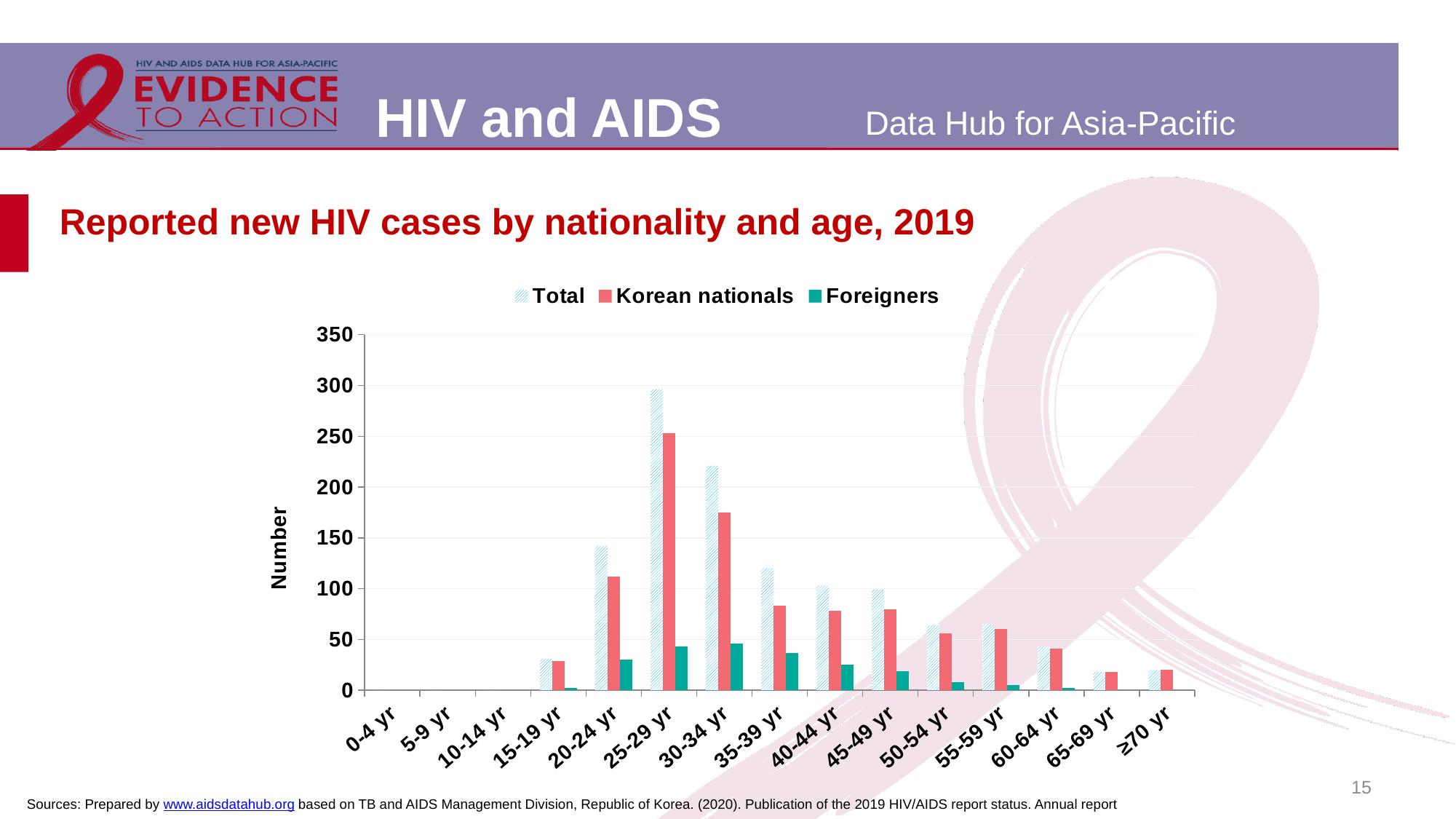
Which is larger, the Total value for 30-34 yr or for 35-39 yr? 30-34 yr Which age group has the highest value for Korean nationals? 25-29 yr What type of chart is shown on the slide? Bar chart Do the Total values rise or fall across the age groups from 25-29 yr to ≥70 yr? fall Is the Total value for 25-29 yr greater or less than 250? greater How many series does the legend list? 3 Is the Korean nationals value for 25-29 yr greater or less than 200? greater Is the Korean nationals value for 30-34 yr greater or less than 200? less How many age groups are shown on the x axis? 15 What is the label of the y axis? Number Which age group has the highest Total value? 25-29 yr